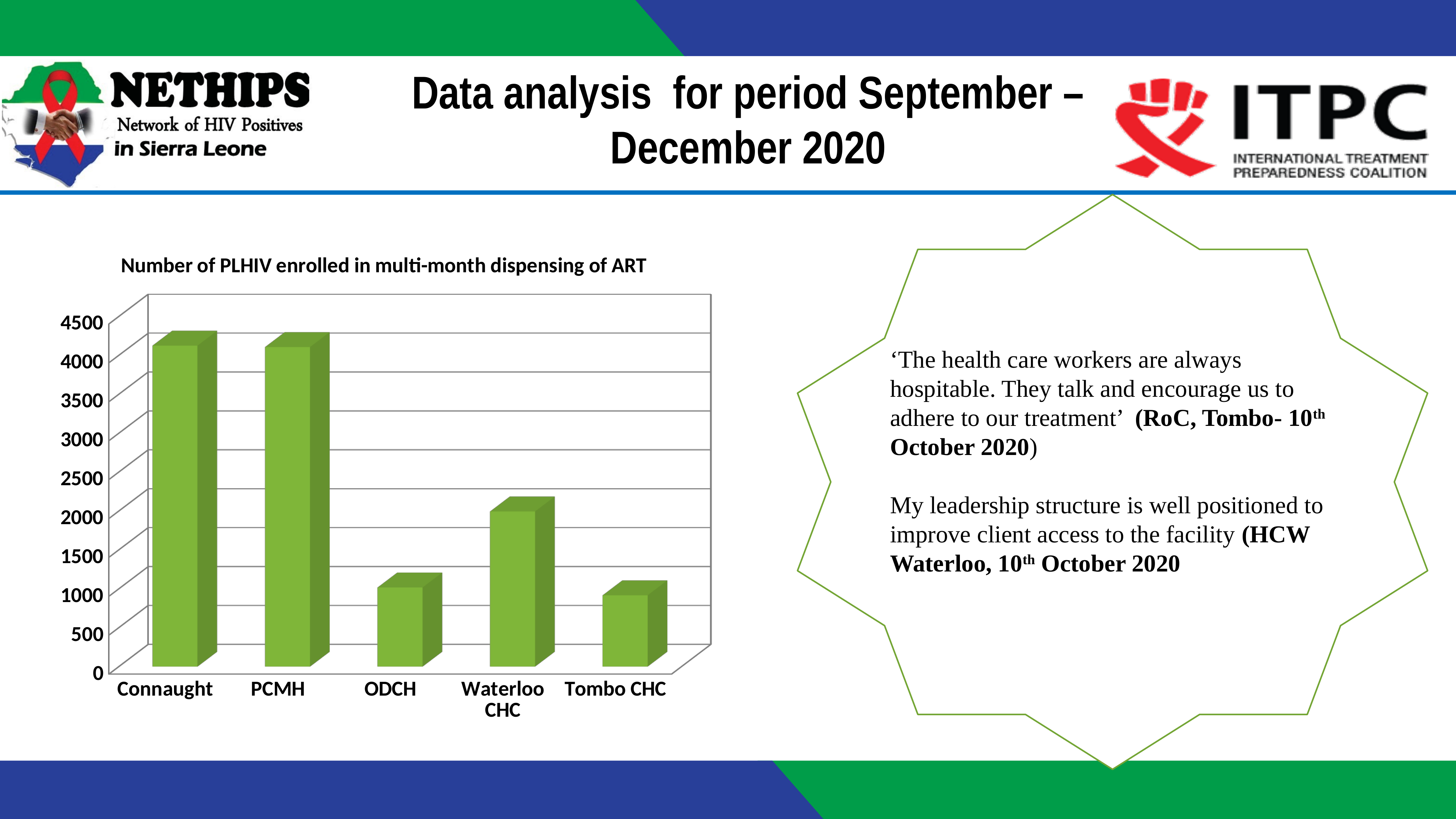
Which has a higher value, Waterloo CHC or Tombo CHC? Waterloo CHC Is the value for PCMH greater or less than 3000? greater Is the value for Waterloo CHC greater or less than 2500? less What is the title of the chart? Number of PLHIV enrolled in multi-month dispensing of ART How many facilities are shown on the x axis of the chart? 5 What kind of chart is shown on the slide? bar chart What colour are the bars in the chart? green Is the value for Connaught greater or less than 3500? greater Which has a higher value, Connaught or ODCH? Connaught